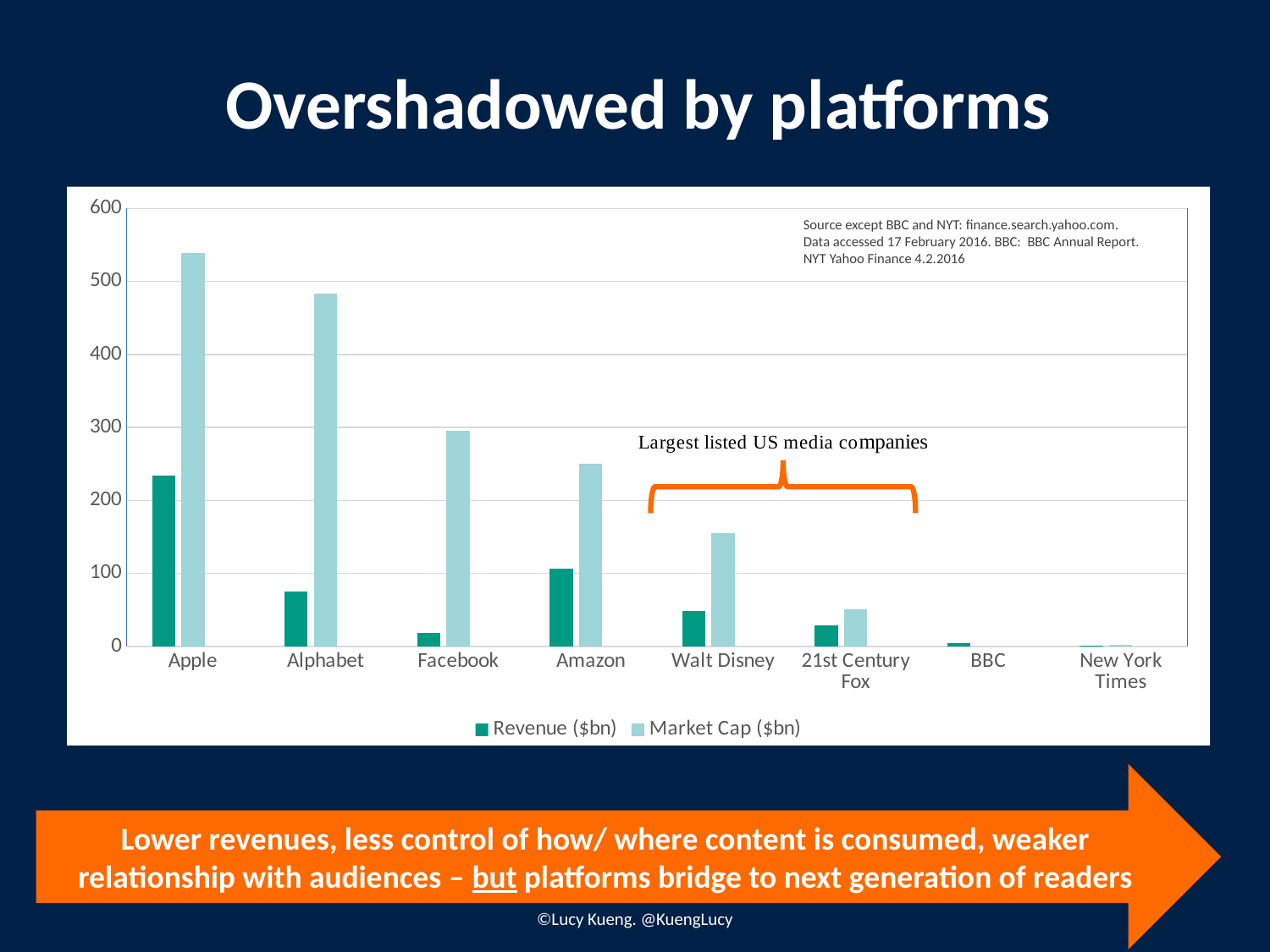
How many companies are shown on the x axis of the chart? 8 Which company has the highest Revenue ($bn)? Apple Is the Revenue ($bn) for Apple greater or less than 200? greater How many series does the chart legend list? 2 Which is larger, the Market Cap ($bn) for Facebook or for Amazon? Facebook Which company has the highest Market Cap ($bn)? Apple Is the Market Cap ($bn) for Walt Disney greater or less than 200? less What kind of chart is shown on the slide? bar chart Which is larger, the Revenue ($bn) for Amazon or for Alphabet? Amazon What are the two series listed in the chart legend? Revenue ($bn) and Market Cap ($bn) Is the Market Cap ($bn) for Apple greater or less than 500? greater